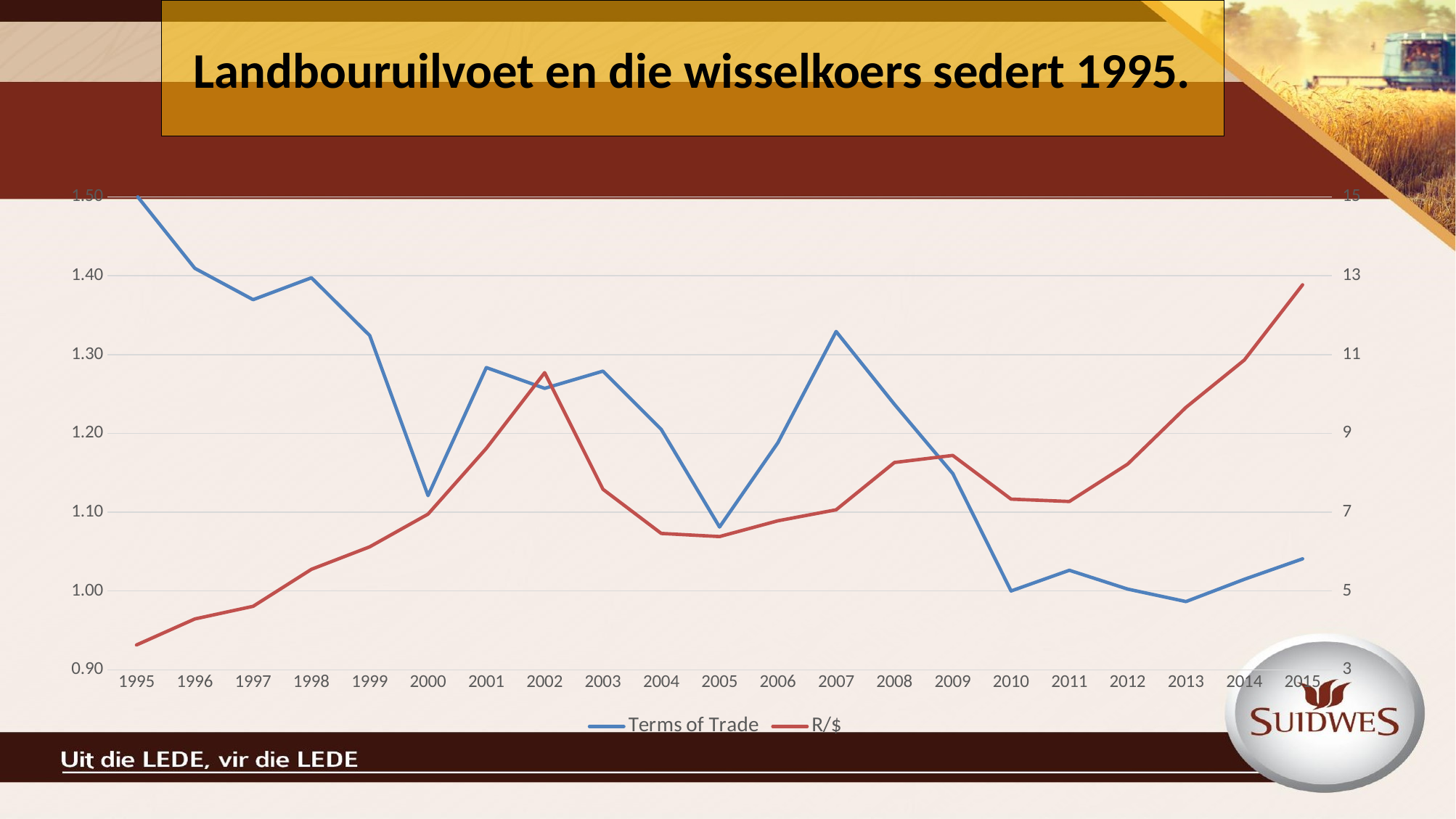
In which year is the Terms of Trade series at its highest? 1995 In which year is the R/$ series at its lowest? 1995 How many series does the legend list? 2 Does the R/$ series rise or fall from 2011 to 2015? rise What kind of chart is shown on the slide? line chart Is the Terms of Trade value for 2000 greater or less than 1.20? less What is the title of the chart on the slide? Landbouruilvoet en die wisselkoers sedert 1995. Is the Terms of Trade value for 2007 greater or less than 1.20? greater How many years are plotted along the x axis? 21 In which year is the R/$ series at its highest? 2015 Which year has the larger Terms of Trade value, 2001 or 2005? 2001 Is the R/$ value for 2015 greater or less than 11? greater